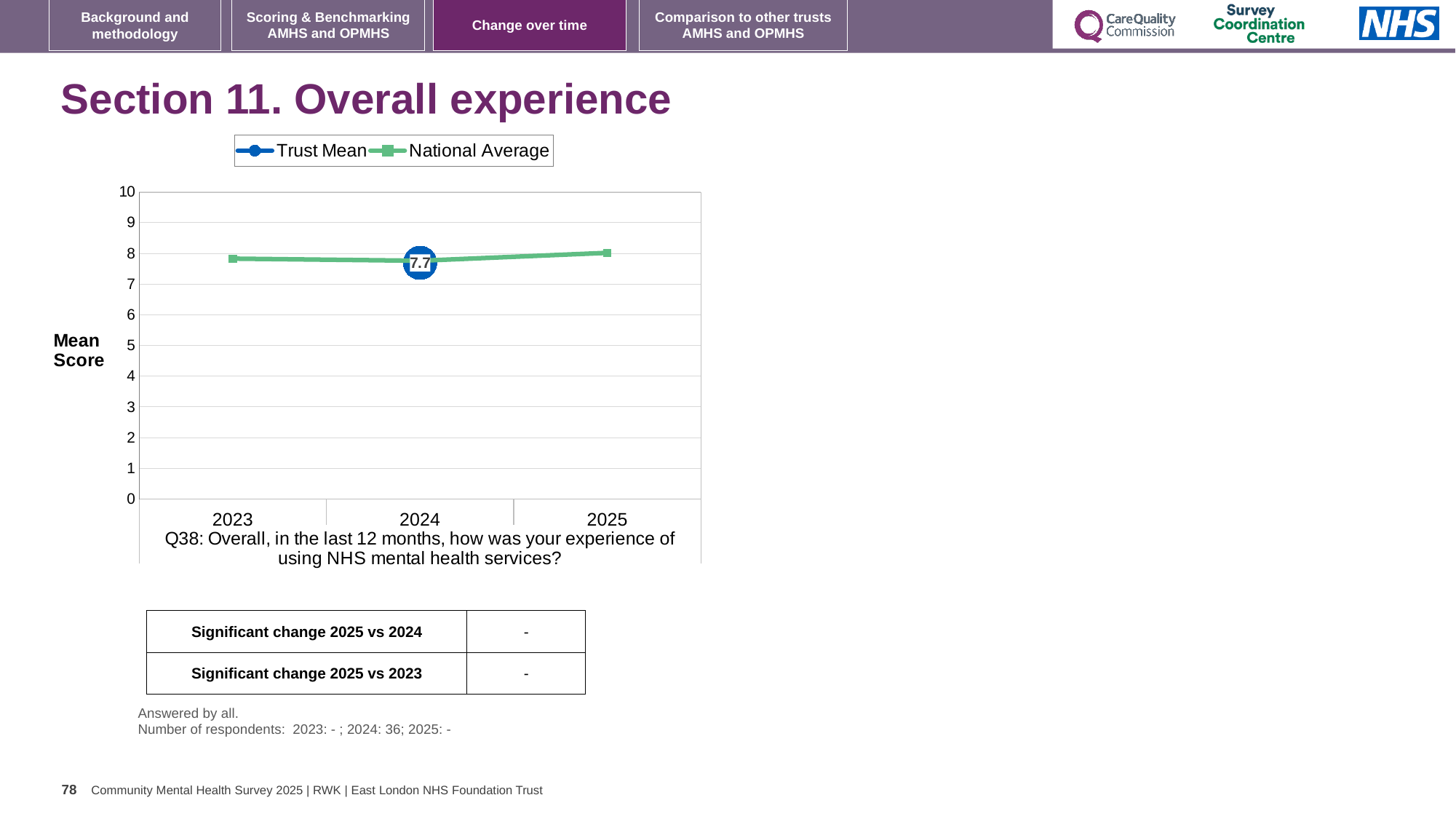
Is the National Average value for 2025 greater or less than 7? greater Does the National Average rise or fall between 2024 and 2025? rise How many years are shown on the x axis? 3 Is the Trust Mean value for 2024 greater or less than 5? greater How many series does the legend list? 2 What kind of chart is shown on the slide? line chart What is the label on the y axis? Mean Score What is the highest value shown on the y axis? 10 Is the National Average value for 2023 greater or less than 9? less Which series is shown in green in the legend? National Average What is the Trust Mean score for 2024? 7.7